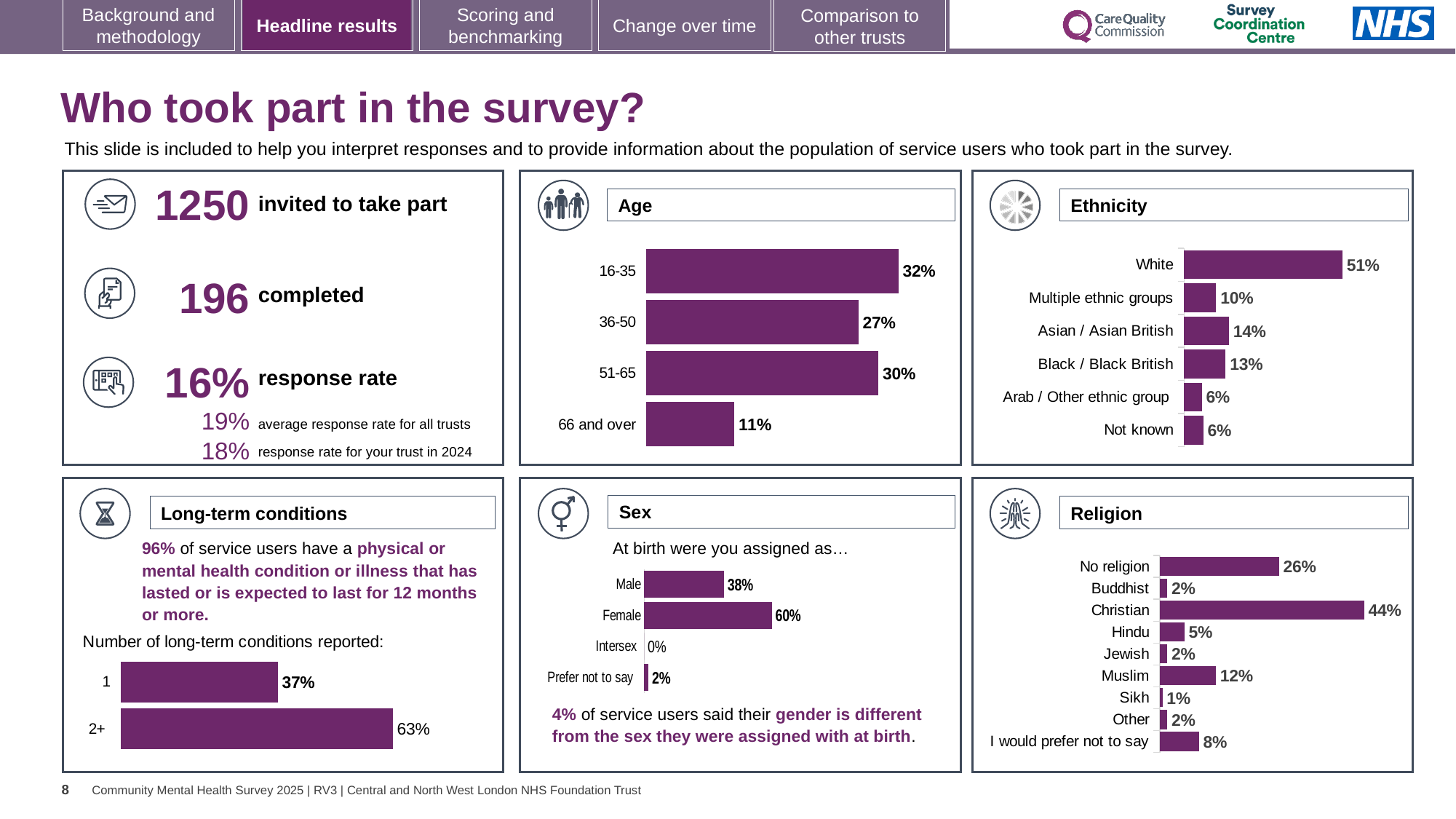
In the Age chart, which age group has the lowest percentage? 66 and over In the Ethnicity chart, what is the difference between White and Black / Black British? 38% In the Religion chart, what is the value for Muslim? 12% In the Religion chart, which religion has the highest percentage? Christian In the Ethnicity chart, how many categories are shown? 6 In the Ethnicity chart, which category has the highest percentage? White In the Sex chart, which is larger, Male or Female? Female In the Long-term conditions chart, what is the difference between the 2+ and 1 categories? 26% What type of chart is used in the Age panel? Bar chart In the Ethnicity chart, what is the value for Asian / Asian British? 14% In the Age chart, what percentage of respondents were aged 16-35? 32% In the Sex chart, what percentage of respondents were assigned Female at birth? 60%